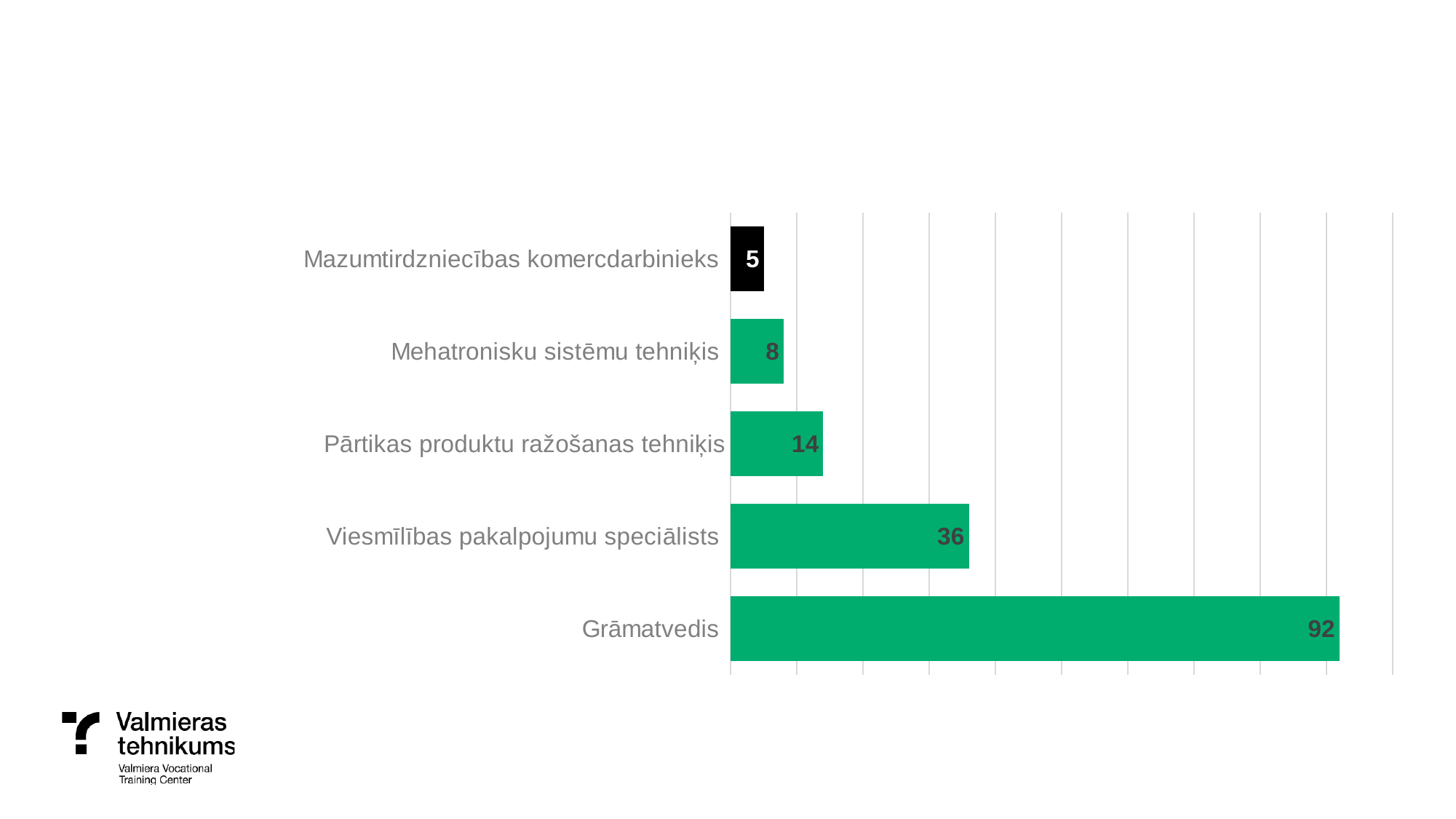
What is the value for Mehatronisku sistēmu tehniķis? 8 What is the value for Grāmatvedis? 92 What kind of chart is shown on the slide? Bar chart How many categories are shown in the chart? 5 What is the value for Viesmīlības pakalpojumu speciālists? 36 Which is larger, the value for Pārtikas produktu ražošanas tehniķis or Mehatronisku sistēmu tehniķis? Pārtikas produktu ražošanas tehniķis What is the difference between the values for Grāmatvedis and Viesmīlības pakalpojumu speciālists? 56 Which category has the highest value? Grāmatvedis What is the value for Pārtikas produktu ražošanas tehniķis? 14 What is the value for Mazumtirdzniecības komercdarbinieks? 5 Which category has the lowest value? Mazumtirdzniecības komercdarbinieks Which bar is coloured black rather than green? Mazumtirdzniecības komercdarbinieks